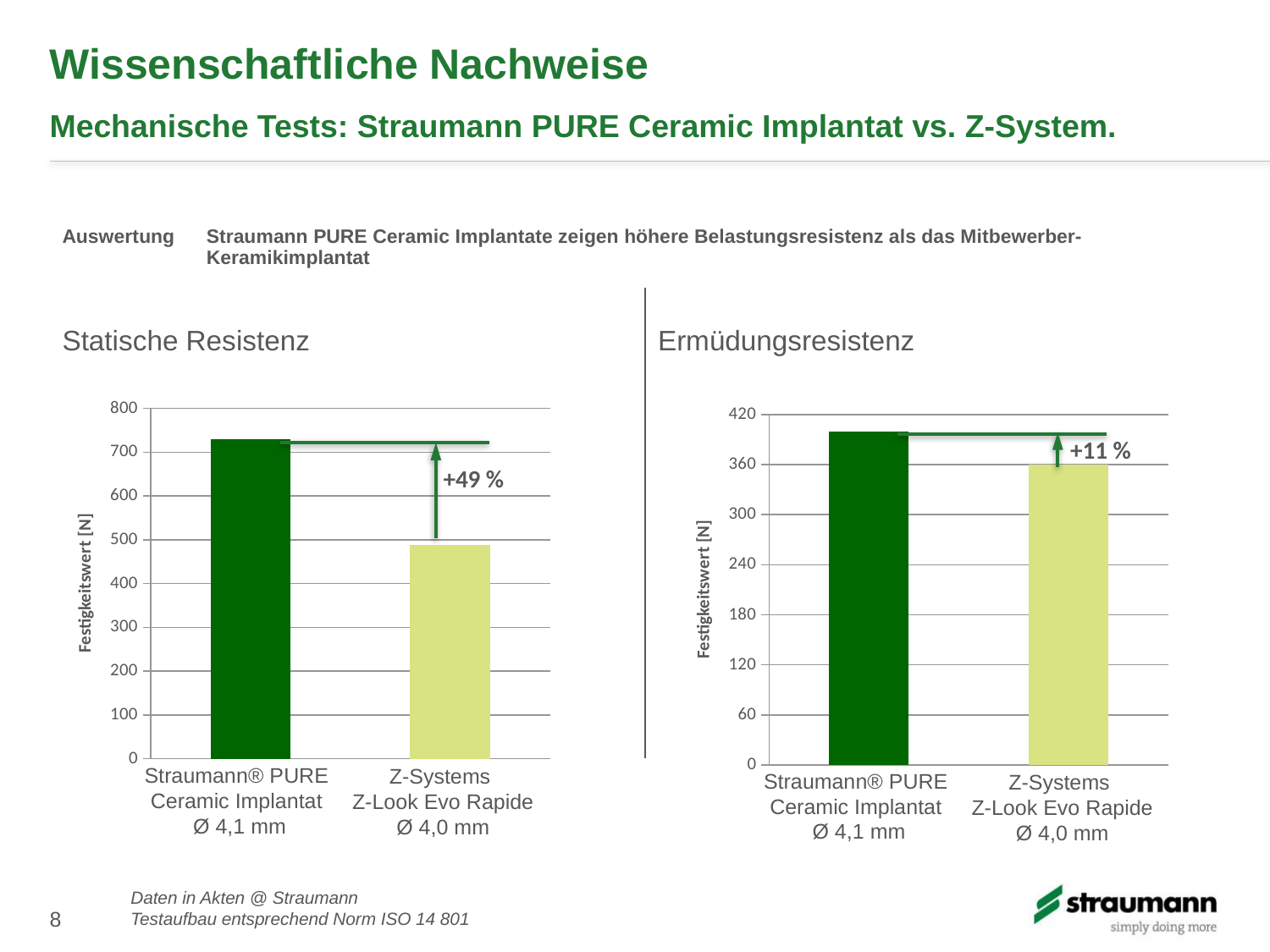
In the "Statische Resistenz" chart, is the value for Z-Systems Z-Look Evo Rapide greater or less than 500? less What is the highest tick value on the y axis of the "Ermüdungsresistenz" chart? 420 How many bars does the "Ermüdungsresistenz" chart on the right show? 2 In the "Statische Resistenz" chart, which bar is taller: Straumann® PURE Ceramic Implantat or Z-Systems Z-Look Evo Rapide? Straumann® PURE Ceramic Implantat In the "Ermüdungsresistenz" chart, is the value for Z-Systems Z-Look Evo Rapide greater or less than 300? greater In the "Ermüdungsresistenz" chart, which implant has the lowest Festigkeitswert? Z-Systems Z-Look Evo Rapide Ø 4,0 mm What percentage advantage is annotated on the "Ermüdungsresistenz" chart? +11 % In the "Ermüdungsresistenz" chart, is the value for Straumann® PURE Ceramic Implantat greater or less than 360? greater What kind of chart is the "Statische Resistenz" chart on the left? bar chart What percentage advantage is annotated on the "Statische Resistenz" chart? +49 % In the "Statische Resistenz" chart, which implant has the highest Festigkeitswert? Straumann® PURE Ceramic Implantat Ø 4,1 mm